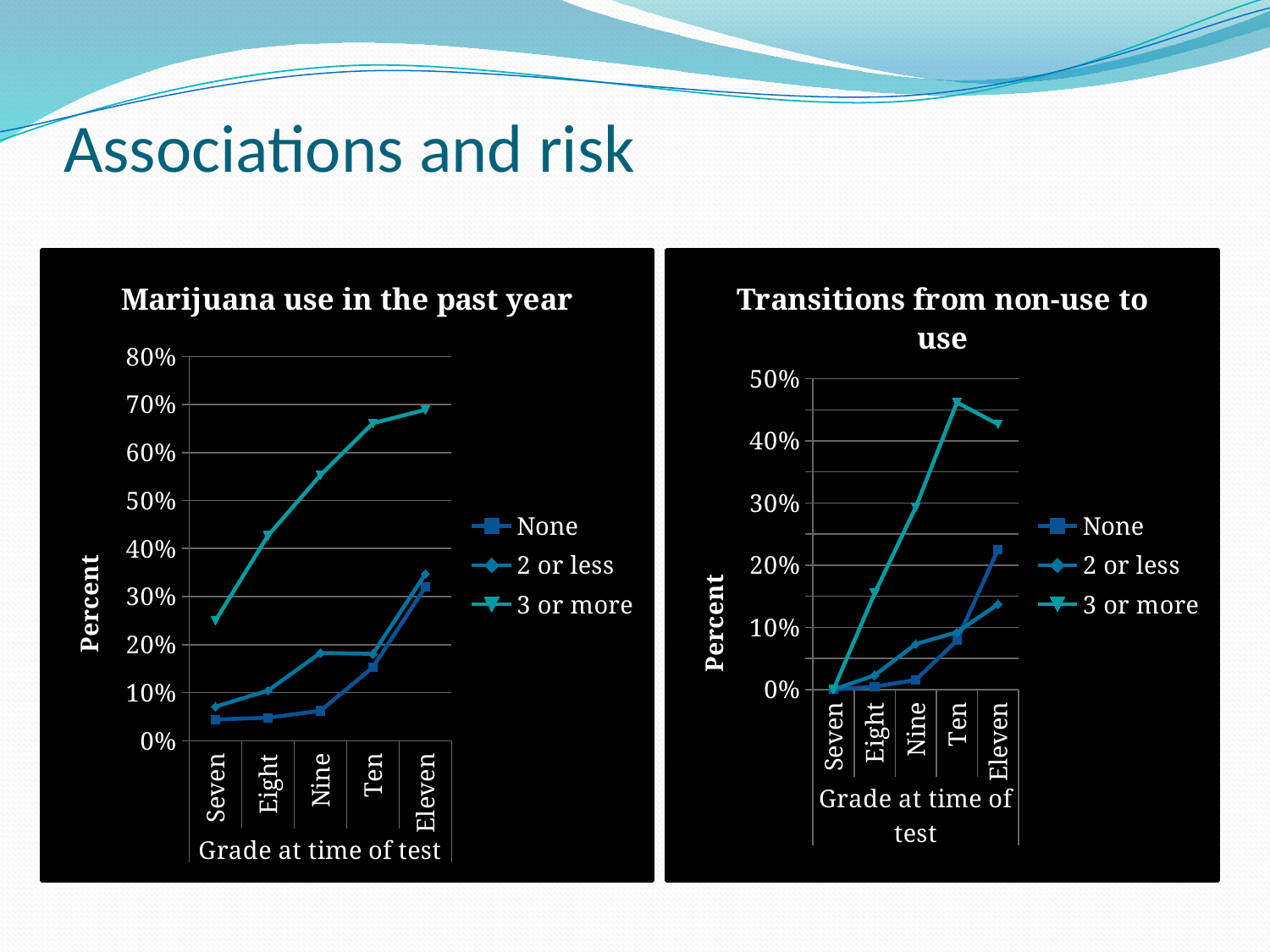
In the chart titled "Transitions from non-use to use", is the value for "2 or less" at grade Nine greater or less than 10%? less In the chart titled "Marijuana use in the past year", which series has the highest value at grade Ten? 3 or more In the chart titled "Marijuana use in the past year", what kind of chart is shown? line chart In the chart titled "Marijuana use in the past year", how many series does the legend list? 3 In the chart titled "Marijuana use in the past year", how many grade categories are shown on the x axis? 5 In the chart titled "Transitions from non-use to use", is the value for "3 or more" at grade Ten greater or less than 40%? greater In the chart titled "Marijuana use in the past year", is the value for "None" at grade Seven greater or less than 10%? less In the chart titled "Transitions from non-use to use", what is the label on the y axis? Percent In the chart titled "Transitions from non-use to use", at which grade does the "3 or more" series reach its highest value? Ten In the chart titled "Marijuana use in the past year", does the "3 or more" series rise or fall from grade Seven to grade Eleven? rises In the chart titled "Transitions from non-use to use", at grade Eleven, which is larger: "None" or "2 or less"? None